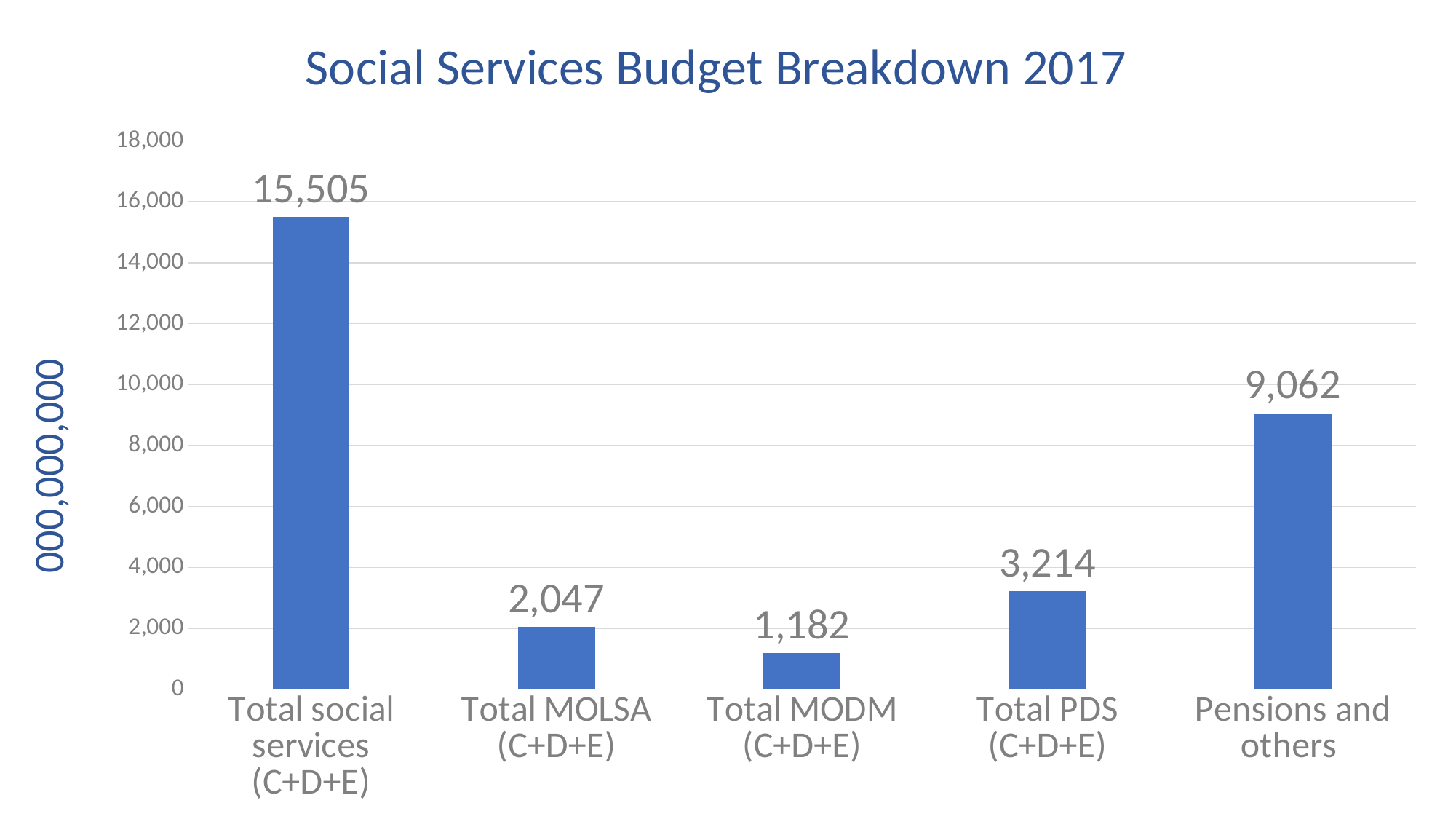
What kind of chart is this? bar chart What is the value for Total MODM (C+D+E)? 1,182 What is the title of the chart? Social Services Budget Breakdown 2017 Which is larger, Pensions and others or Total PDS (C+D+E)? Pensions and others What is the value for Pensions and others? 9,062 Is the value for Pensions and others greater or less than 10,000? less How many categories are shown on the chart? 5 Which category has the lowest value? Total MODM (C+D+E) What is the difference between Total PDS (C+D+E) and Total MOLSA (C+D+E)? 1,167 What is the value for Total MOLSA (C+D+E)? 2,047 Which category has the highest value? Total social services (C+D+E) What is the value for Total social services (C+D+E)? 15,505